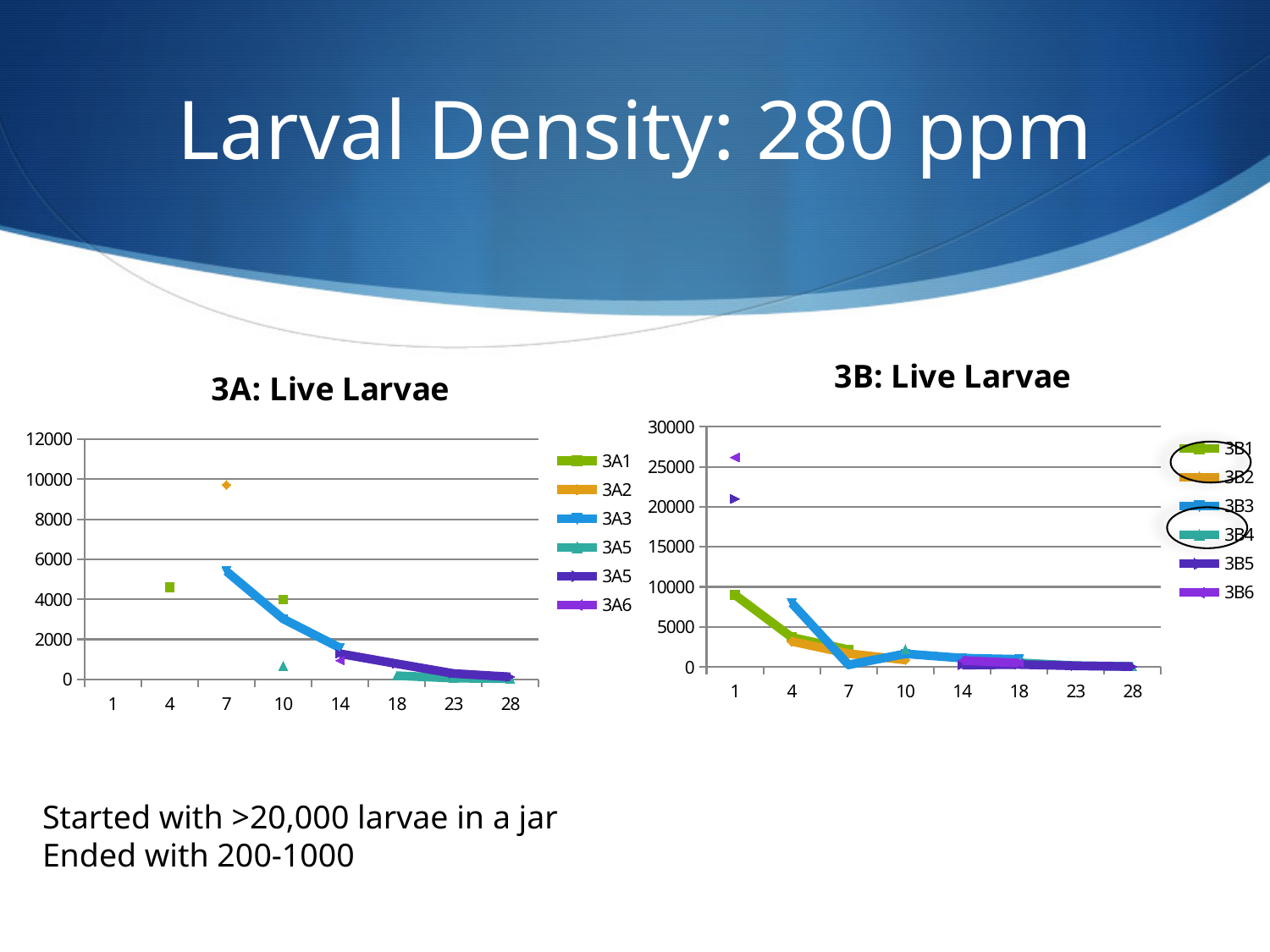
How many x-axis categories (days) are shown on the '3B: Live Larvae' chart? 8 In the '3B: Live Larvae' chart, is the value for 3B6 at day 1 greater or less than 20000? greater In the '3B: Live Larvae' chart, is the value for 3B1 at day 1 greater or less than 5000? greater What type of chart is the '3A: Live Larvae' chart? line chart What is the title of the chart on the right side of the slide? 3B: Live Larvae How many series does the legend of the '3A: Live Larvae' chart list? 6 In the '3A: Live Larvae' chart, is the value for 3A1 at day 4 greater or less than 6000? less How many series does the legend of the '3B: Live Larvae' chart list? 6 In the '3A: Live Larvae' chart, does the 3A3 series rise or fall from day 7 to day 14? fall